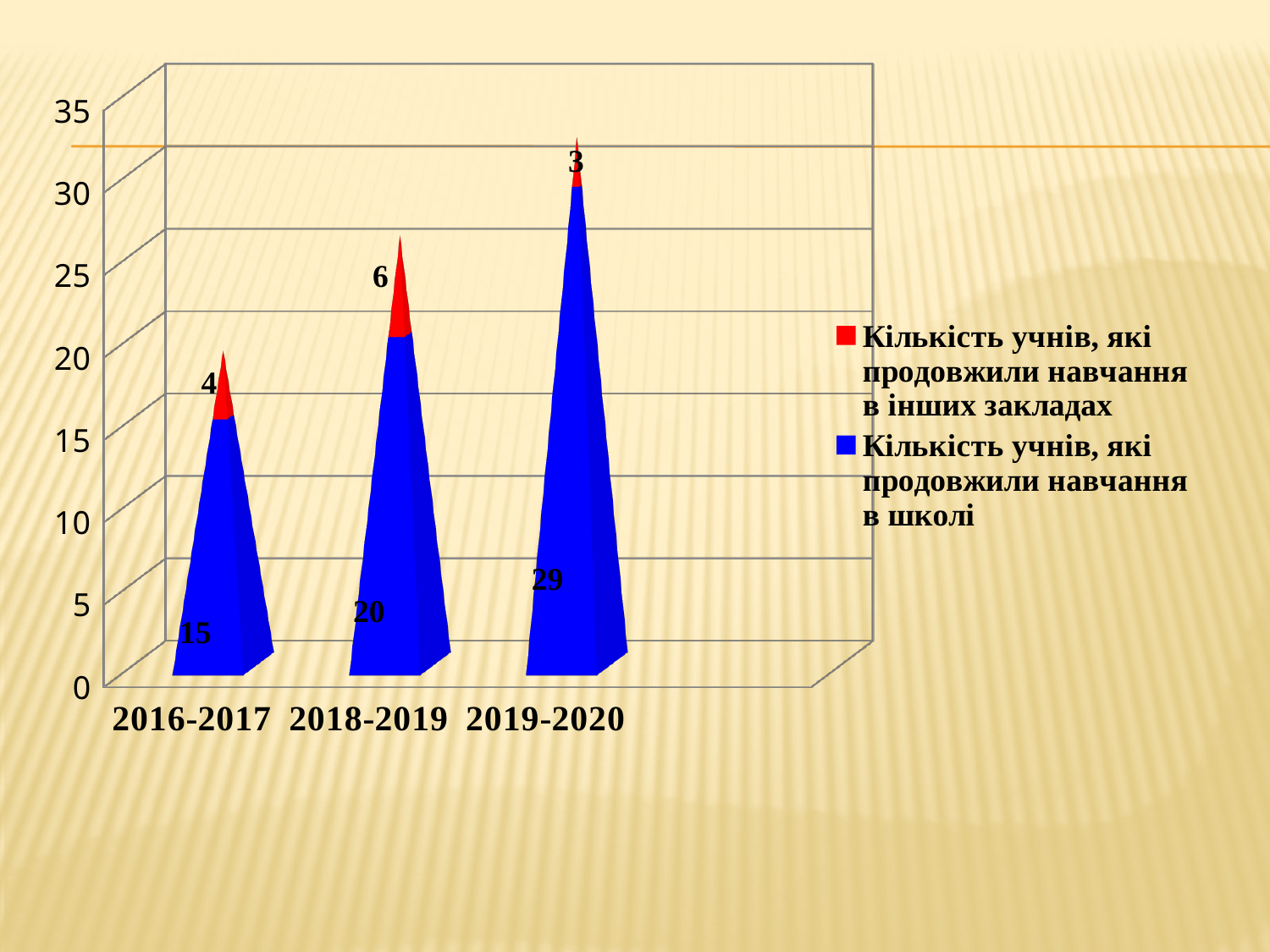
What is the value for 2018-2019 in the series "Кількість учнів, які продовжили навчання в інших закладах"? 6 What is the difference between the 2019-2020 and 2016-2017 values for "Кількість учнів, які продовжили навчання в школі"? 14 How many series does the legend list? 2 Which year has the lowest value for "Кількість учнів, які продовжили навчання в інших закладах"? 2019-2020 Which year has the highest value for "Кількість учнів, які продовжили навчання в школі"? 2019-2020 What is the value for 2019-2020 in the series "Кількість учнів, які продовжили навчання в школі"? 29 What is the value for 2019-2020 in the series "Кількість учнів, які продовжили навчання в інших закладах"? 3 Which is larger: the 2018-2019 value or the 2016-2017 value for "Кількість учнів, які продовжили навчання в інших закладах"? 2018-2019 What is the total of the stacked bar for 2018-2019? 26 What is the value for 2016-2017 in the series "Кількість учнів, які продовжили навчання в школі"? 15 Does the value for "Кількість учнів, які продовжили навчання в школі" rise or fall from 2016-2017 to 2019-2020? rise How many year categories are shown on the x axis? 3